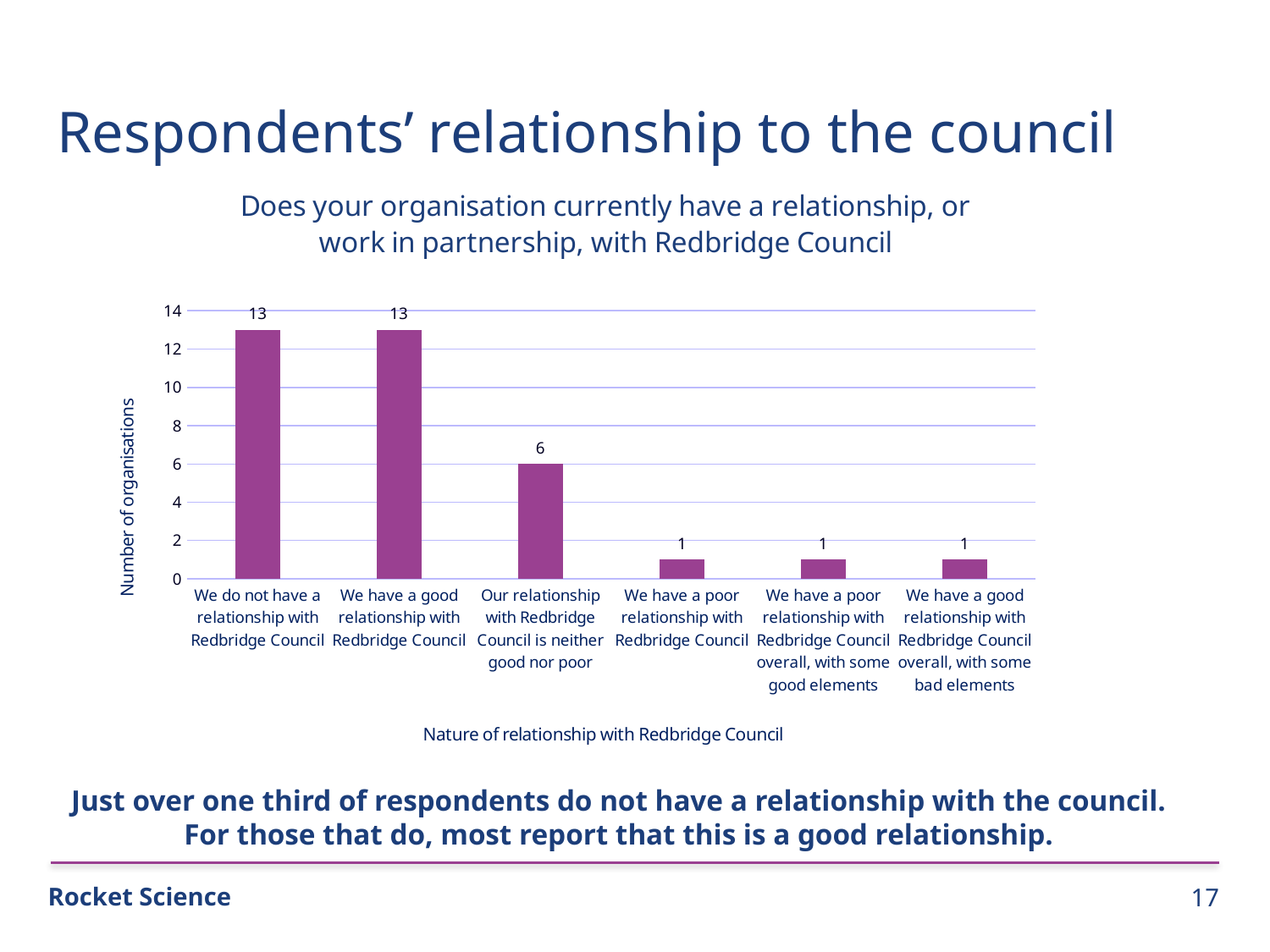
How many organisations said 'We have a poor relationship with Redbridge Council'? 1 How many organisations said 'We do not have a relationship with Redbridge Council'? 13 What is the label of the y axis of the chart? Number of organisations What kind of chart is shown on the slide? Bar chart Is the value for 'Our relationship with Redbridge Council is neither good nor poor' greater or less than 8? less What is the label of the x axis of the chart? Nature of relationship with Redbridge Council Is the value for 'We have a good relationship with Redbridge Council' greater or less than 10? greater Which category has the lowest value, 'We have a good relationship with Redbridge Council' or 'Our relationship with Redbridge Council is neither good nor poor'? Our relationship with Redbridge Council is neither good nor poor How many categories are shown on the x axis of the chart? 6 What is the difference between the value for 'We have a good relationship with Redbridge Council' and the value for 'Our relationship with Redbridge Council is neither good nor poor'? 7 What is the difference between the value for 'We do not have a relationship with Redbridge Council' and the value for 'We have a poor relationship with Redbridge Council'? 12 What is the value for 'Our relationship with Redbridge Council is neither good nor poor'? 6